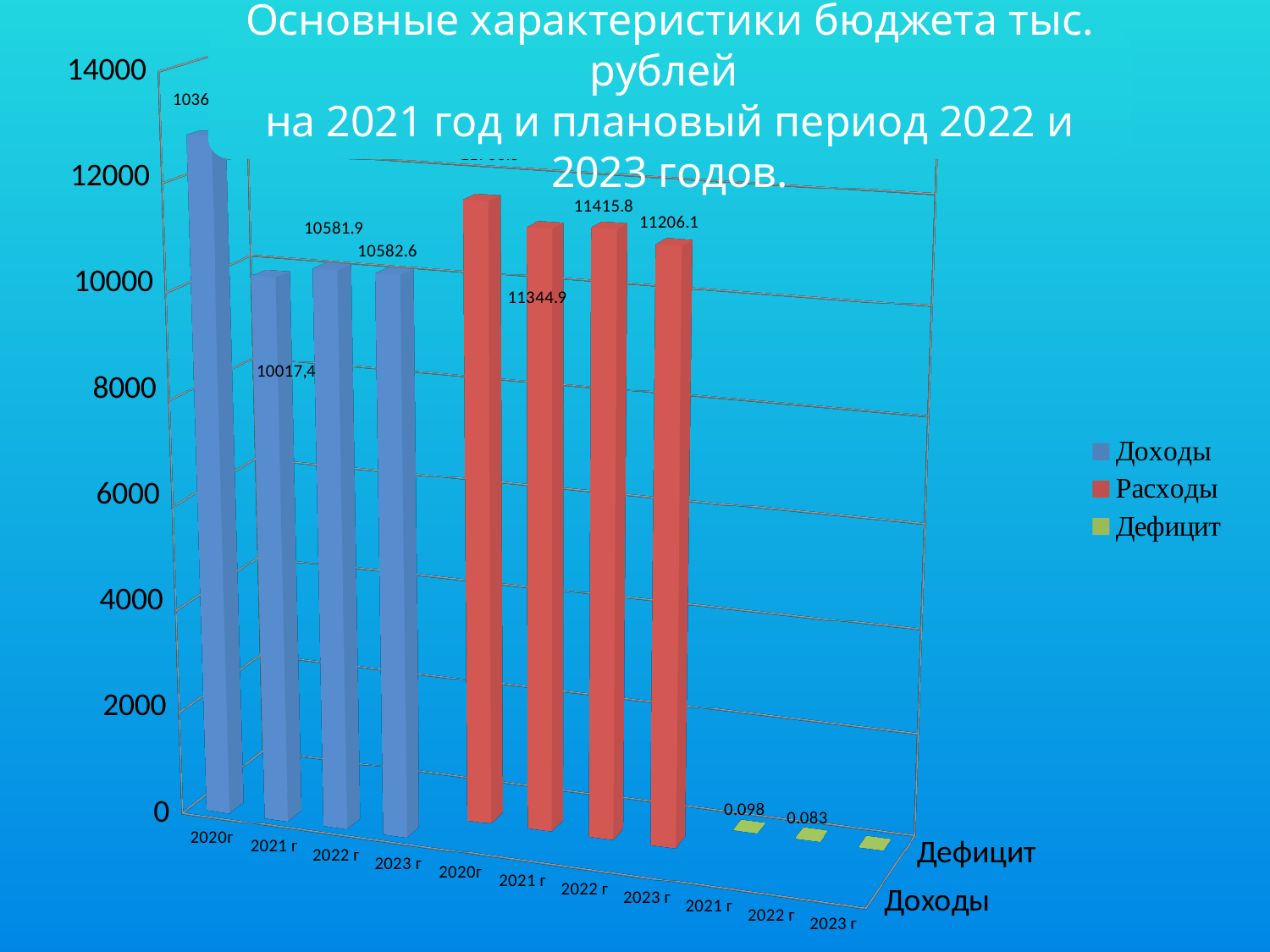
How many series does the legend list? 3 Which year has the lowest Доходы value? 2021 г Which is larger: Расходы for 2022 г or Расходы for 2023 г? Расходы for 2022 г What kind of chart is shown on the slide? bar chart What is the difference between Расходы for 2022 г and Расходы for 2023 г? 209.7 What is the value of Доходы for 2021 г? 10017,4 What is the value of Расходы for 2022 г? 11415.8 What is the value of Дефицит for 2021 г? 0.098 Which year has the highest Доходы value? 2020г Is the Доходы value for 2020г greater or less than 12000? greater What is the value of Доходы for 2023 г? 10582.6 What is the value of Расходы for 2023 г? 11206.1